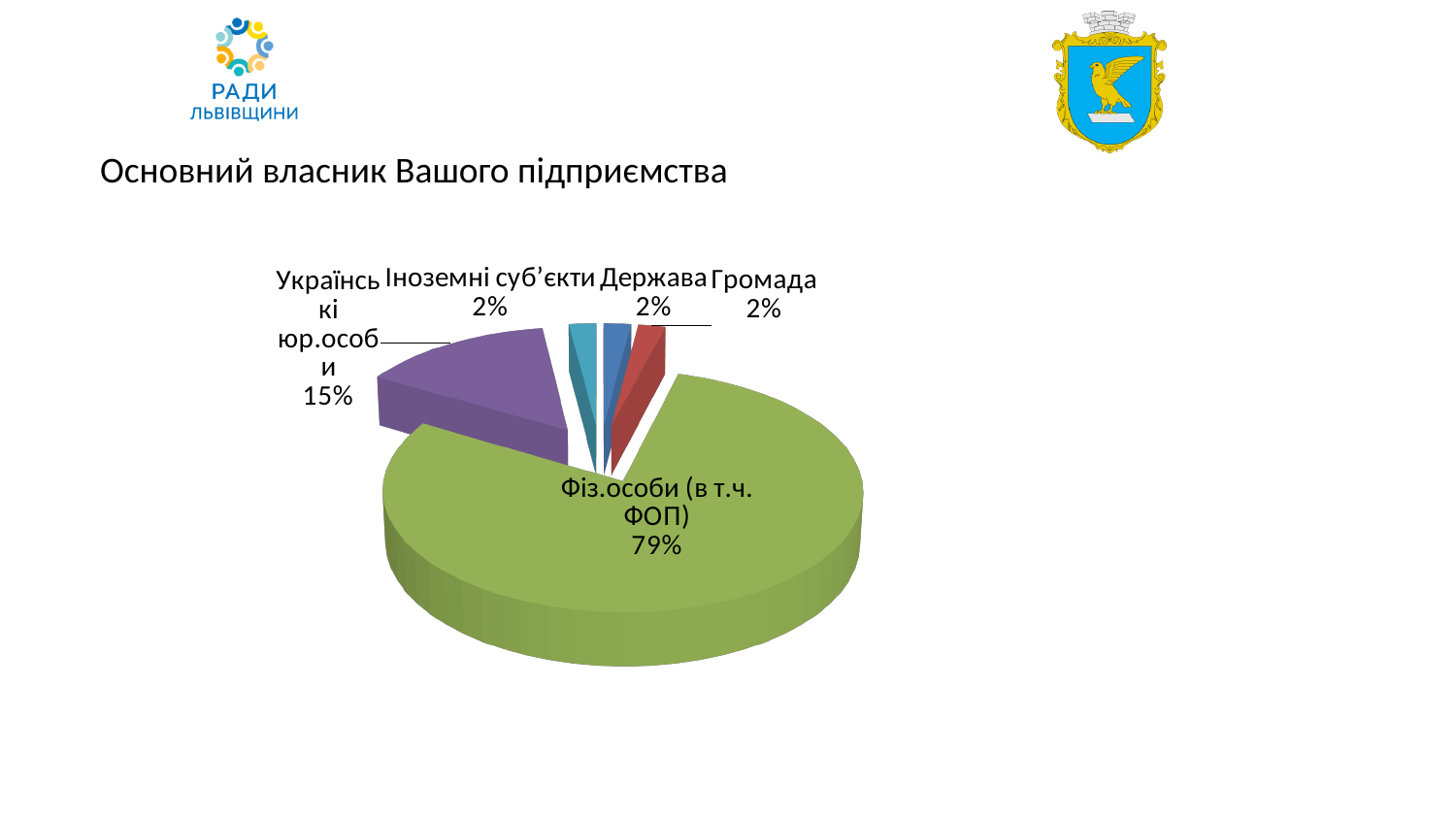
Which is larger, the share for Українські юр.особи or the share for Держава? Українські юр.особи How many slices does the pie chart have? 5 What share of the pie is labelled for Українські юр.особи? 15% What value is shown for Держава? 2% What value is shown for Іноземні суб’єкти? 2% What share of the pie is labelled for Фіз.особи (в т.ч. ФОП)? 79% What kind of chart is shown on the slide? Pie chart What value is shown for Громада? 2% What is the difference between the shares of Фіз.особи (в т.ч. ФОП) and Українські юр.особи? 64% What colour is the slice for Фіз.особи (в т.ч. ФОП)? Green What is the title of the chart on the slide? Основний власник Вашого підприємства Which category has the largest slice of the pie? Фіз.особи (в т.ч. ФОП)